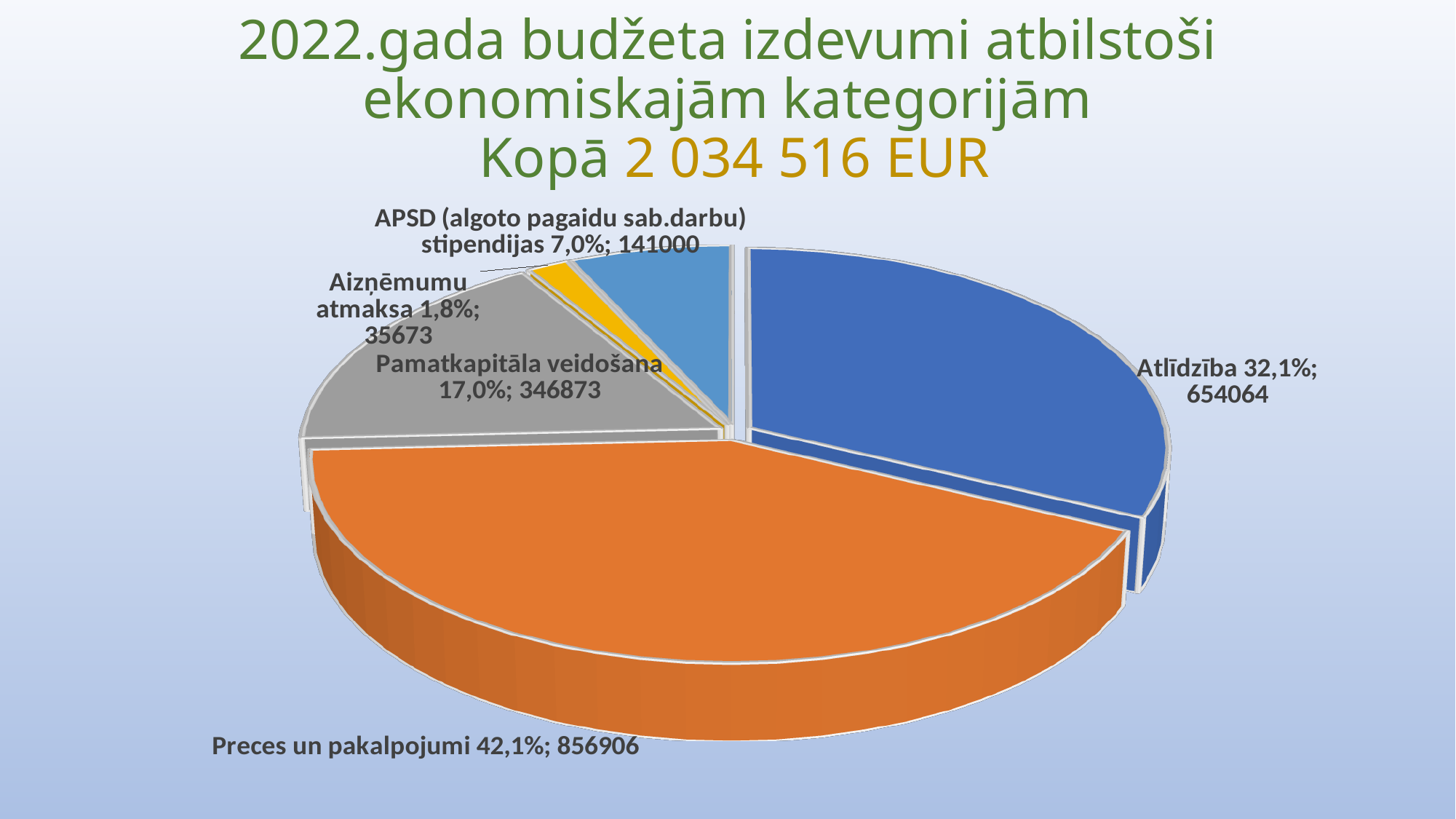
What kind of chart is shown on the slide? pie chart Which category has the largest slice? Preces un pakalpojumi What share of the pie does APSD (algoto pagaidu sab.darbu) stipendijas represent? 7,0% What value is shown for Preces un pakalpojumi? 856906 How many slices does the pie chart have? 5 Which category has the smallest slice? Aizņēmumu atmaksa What is the difference between the values for Preces un pakalpojumi and Atlīdzība? 202842 What value is shown for Pamatkapitāla veidošana? 346873 Which is larger, Atlīdzība or Pamatkapitāla veidošana? Atlīdzība What value is shown for Aizņēmumu atmaksa? 35673 What value is shown for Atlīdzība? 654064 What share of the pie does Preces un pakalpojumi represent? 42,1%